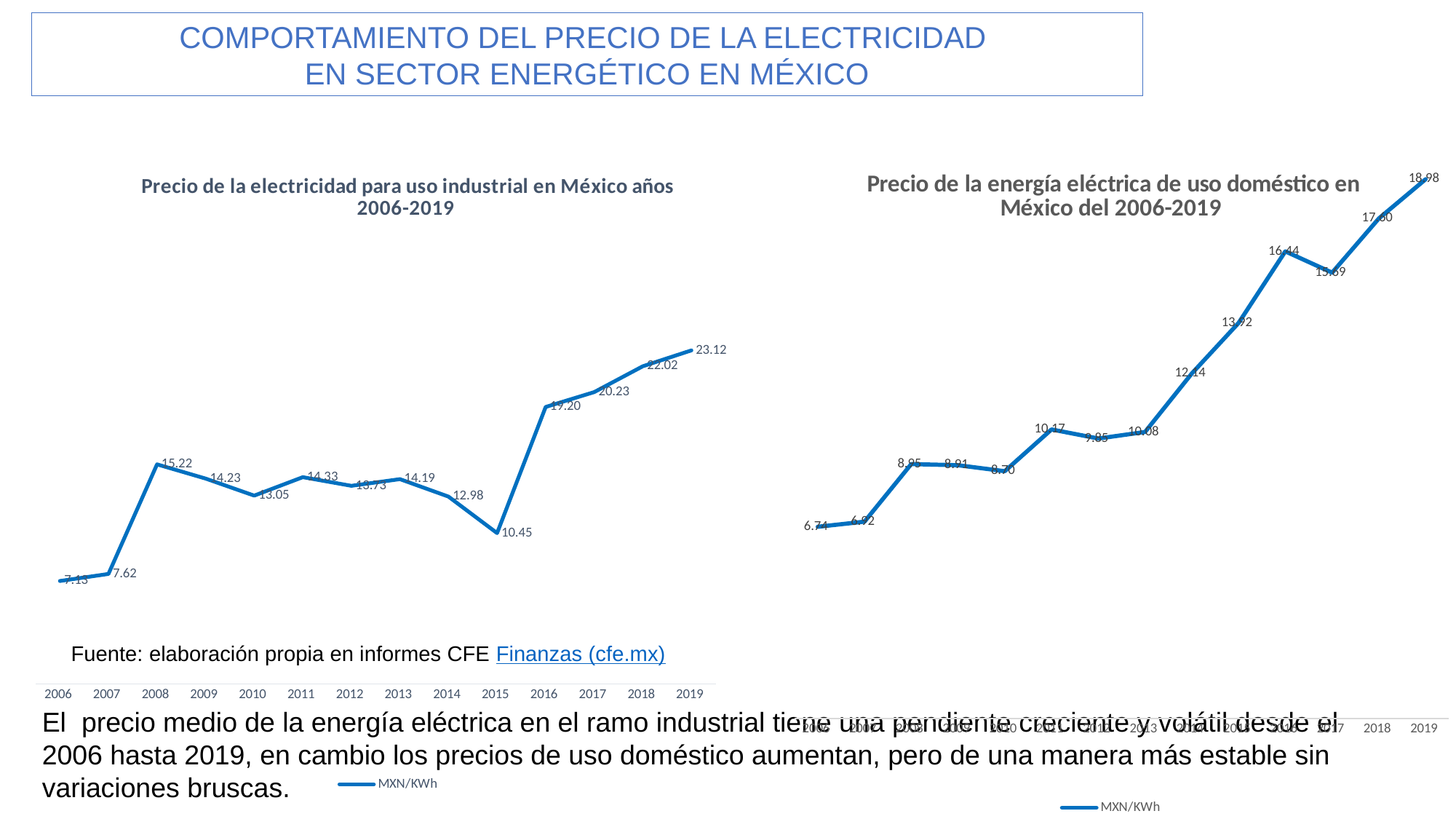
In the chart 'Precio de la electricidad para uso industrial en México años 2006-2019', what is the value for 2019? 23.12 How many series does the legend of the chart 'Precio de la energía eléctrica de uso doméstico en México del 2006-2019' list? 1 In the chart 'Precio de la electricidad para uso industrial en México años 2006-2019', what is the difference between the values for 2016 and 2015? 8.75 In the chart 'Precio de la electricidad para uso industrial en México años 2006-2019', which is larger, the value for 2008 or the value for 2009? 2008 In the chart 'Precio de la electricidad para uso industrial en México años 2006-2019', what is the value for 2015? 10.45 What kind of chart is the chart on the left of the slide? line chart In the chart 'Precio de la electricidad para uso industrial en México años 2006-2019', which year has the highest value? 2019 In the chart 'Precio de la energía eléctrica de uso doméstico en México del 2006-2019', what is the value for 2016? 16.44 In the chart 'Precio de la energía eléctrica de uso doméstico en México del 2006-2019', what is the value for 2019? 18.98 In the chart 'Precio de la energía eléctrica de uso doméstico en México del 2006-2019', do the values overall rise or fall from 2006 to 2019? rise In the chart 'Precio de la electricidad para uso industrial en México años 2006-2019', what is the difference between the values for 2019 and 2018? 1.10 In the chart 'Precio de la electricidad para uso industrial en México años 2006-2019', which year has the lowest value? 2006